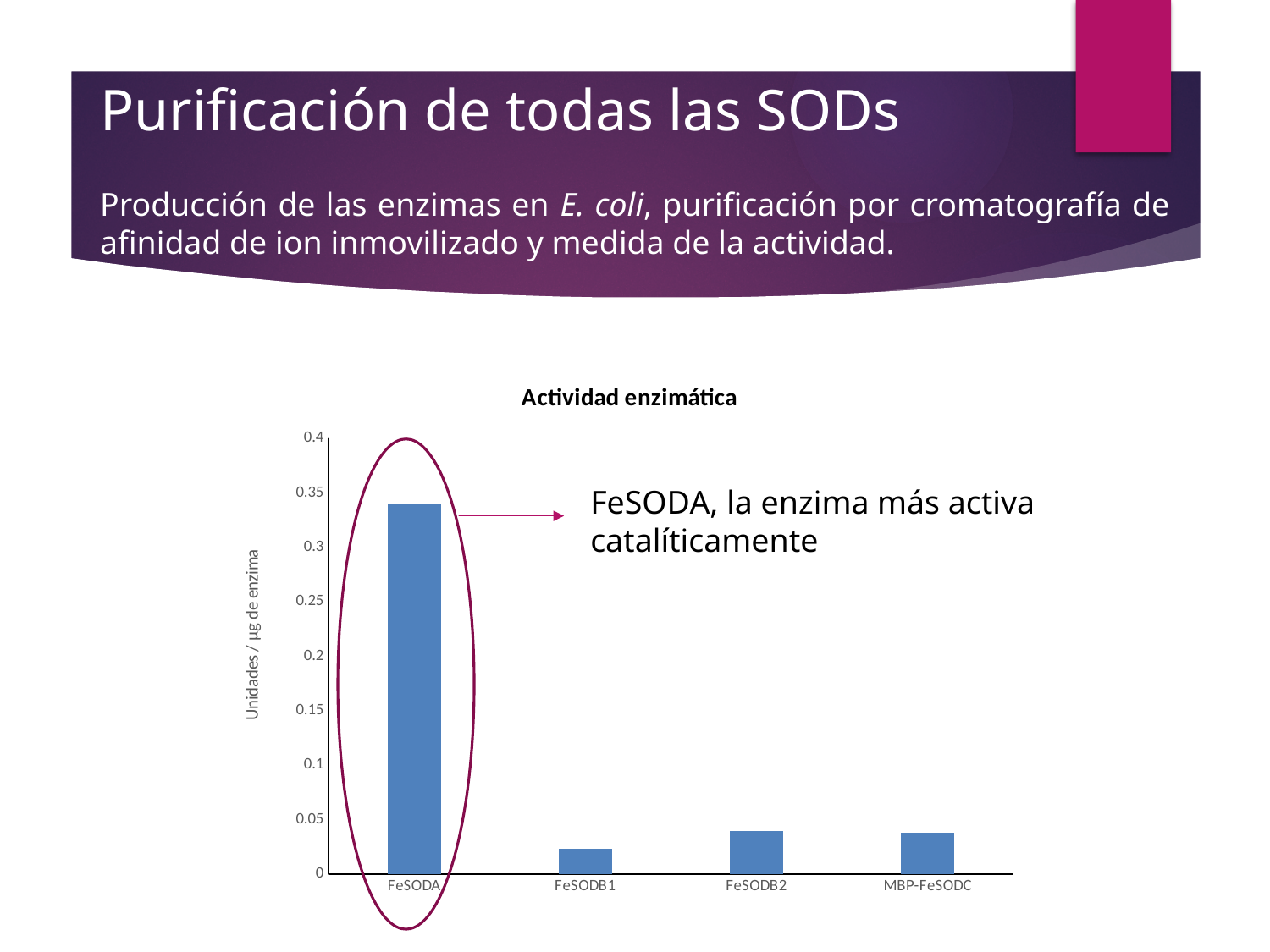
Which category has the lowest enzymatic activity? FeSODB1 What kind of chart is shown on the slide? Bar chart What is the title of the chart? Actividad enzimática Which category has the highest enzymatic activity? FeSODA What is the label of the vertical axis of the chart? Unidades / µg de enzima Is the value for FeSODA greater or less than 0.3? greater Which has a larger value, FeSODB2 or FeSODB1? FeSODB2 How many categories are plotted on the x axis of the chart? 4 Is the value for FeSODA greater or less than 0.35? less Is the value for MBP-FeSODC greater or less than 0.1? less Which has a larger value, FeSODA or FeSODB2? FeSODA